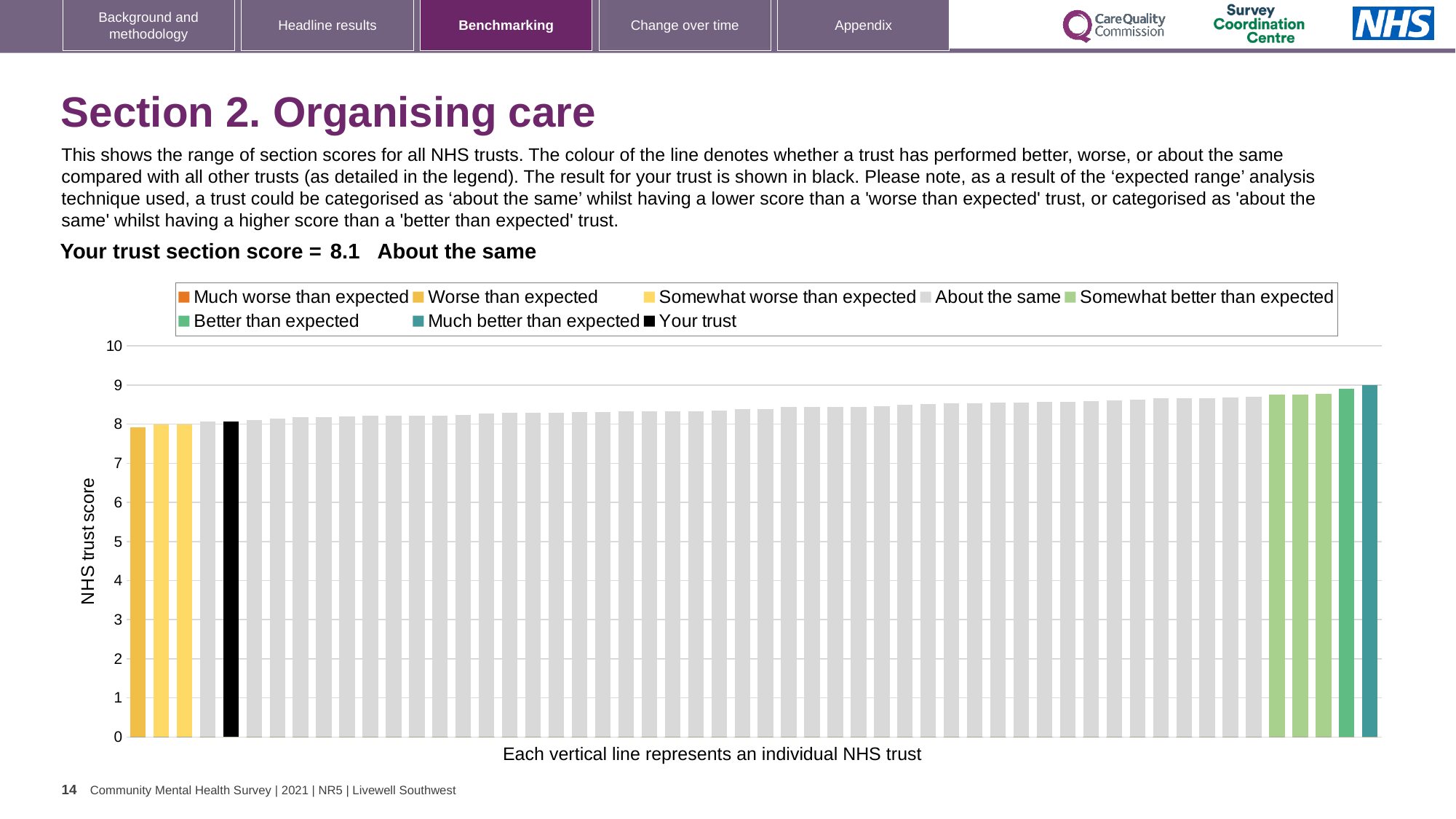
What is the highest value shown on the vertical axis? 10 Which category is your trust placed in for this section? About the same What is the label on the vertical axis of the chart? NHS trust score Is the value for your trust's bar greater or less than 5? greater Do the bar values rise or fall moving from left to right along the x axis? Rise What colour is the bar representing your trust? Black Is the value of the shortest bar greater or less than 9? less How many entries does the chart legend list? 8 Is the value of the tallest bar greater or less than 8? greater What kind of chart is shown on the slide? Bar chart What is the section score for your trust shown on the slide? 8.1 Which legend category does the tallest bar on the chart belong to? Much better than expected